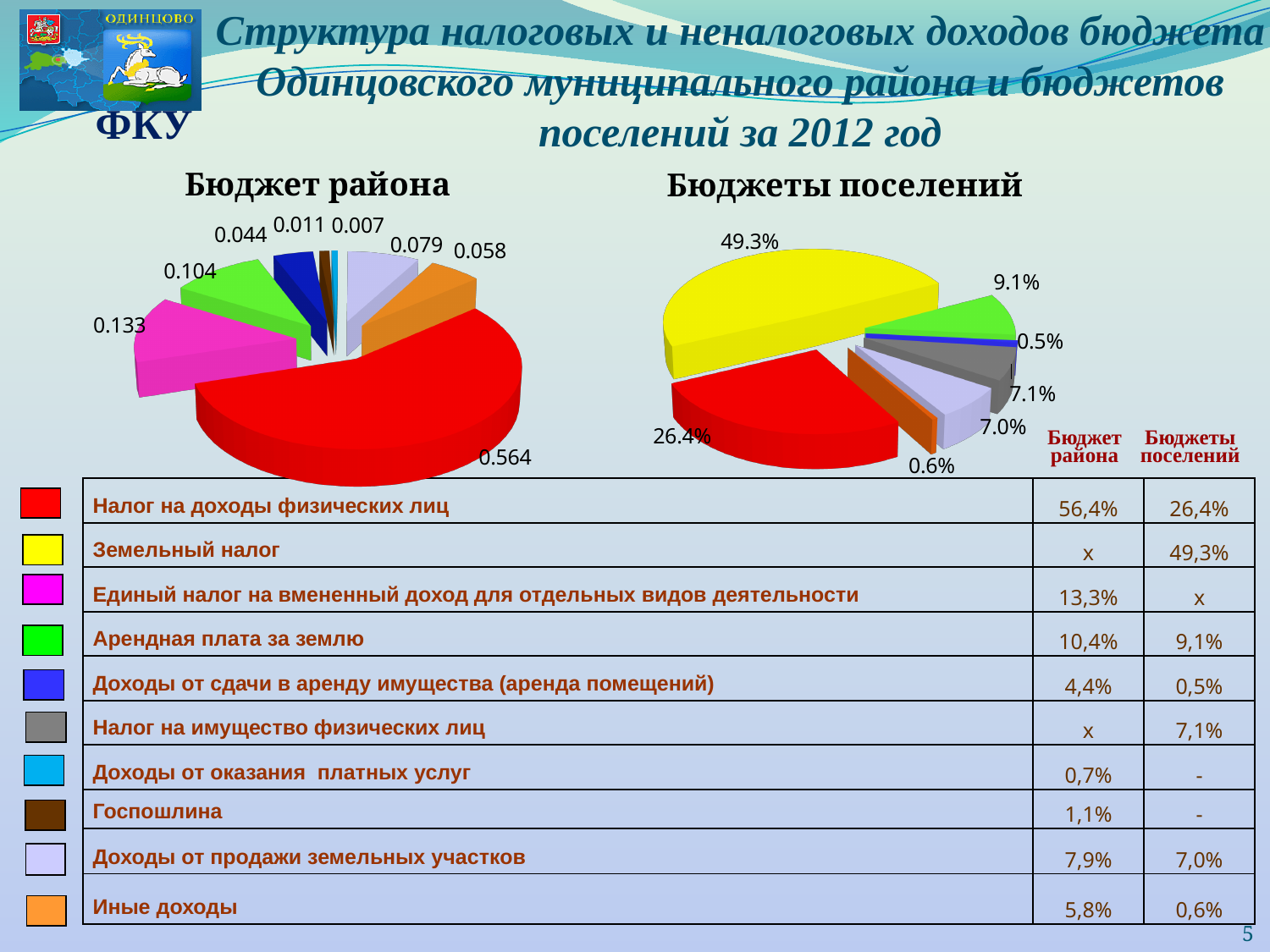
In the "Бюджет района" chart, what value is shown for the magenta slice (Единый налог на вмененный доход)? 0.133 In the "Бюджеты поселений" chart, which category has the largest slice? Земельный налог What kind of chart is used for "Бюджет района"? pie chart In the "Бюджеты поселений" chart, which category has the smallest slice? Доходы от сдачи в аренду имущества (аренда помещений) In the "Бюджеты поселений" chart, what share is shown for the red slice (Налог на доходы физических лиц)? 26.4% In the "Бюджет района" chart, which category has the smallest slice? Доходы от оказания платных услуг How many slices does the "Бюджет района" pie chart have? 8 In the "Бюджет района" chart, what is the value of the largest slice (Налог на доходы физических лиц)? 0.564 In the "Бюджеты поселений" chart, what share does the yellow slice (Земельный налог) have? 49.3% In the "Бюджеты поселений" chart, which is larger: the Арендная плата за землю slice or the Налог на имущество физических лиц slice? Арендная плата за землю How many slices does the "Бюджеты поселений" pie chart have? 7 In the "Бюджеты поселений" chart, what is the difference between the Земельный налог slice (49.3%) and the Налог на доходы физических лиц slice (26.4%)? 22.9%